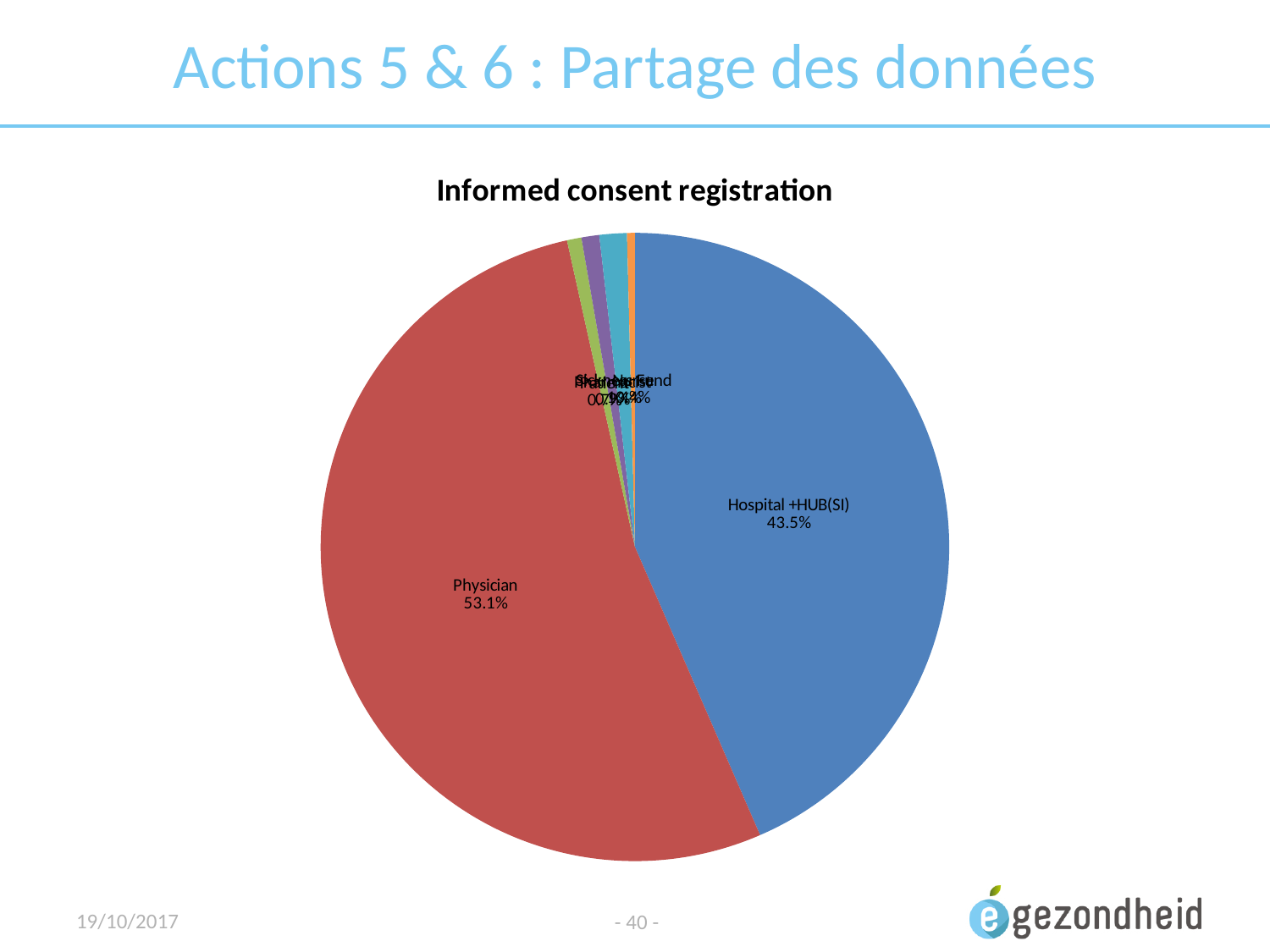
What colour is the Physician slice? red What kind of chart is shown on the slide? pie chart Which category has the largest slice of the pie? Physician What share of the pie does Hospital +HUB(SI) hold? 43.5% What share of the pie does Physician hold? 53.1% What is the title of the chart? Informed consent registration Which is larger, the Physician slice or the Hospital +HUB(SI) slice? Physician By how many percentage points does the Physician share exceed the Hospital +HUB(SI) share? 9.6 percentage points Is the Hospital +HUB(SI) share greater or less than 50%? less Is the Physician share greater or less than 50%? greater What is the combined share of the Physician and Hospital +HUB(SI) slices? 96.6%